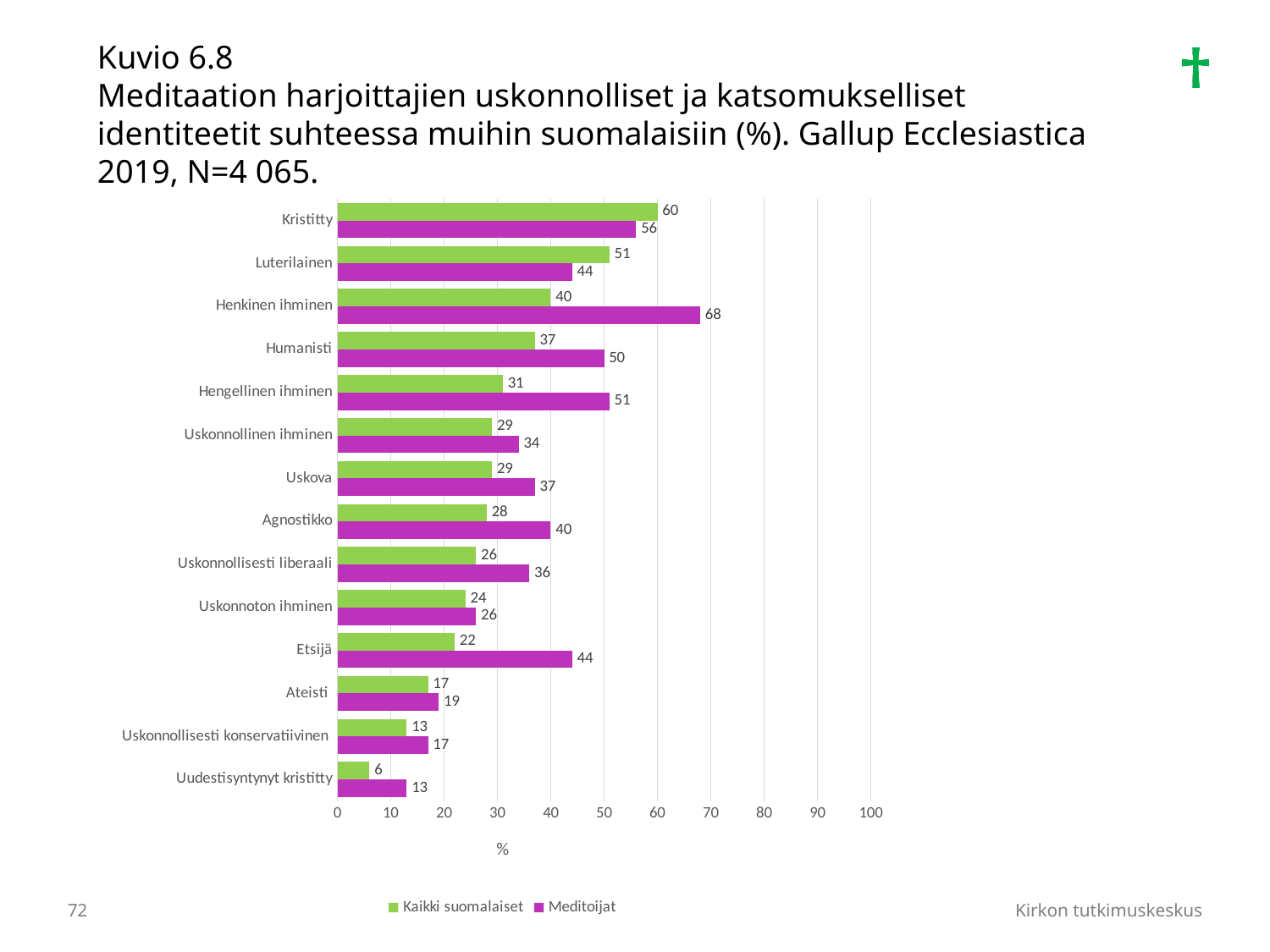
Which is larger for Luterilainen: the value for Kaikki suomalaiset or for Meditoijat? Kaikki suomalaiset Which category has the highest value for Meditoijat? Henkinen ihminen What kind of chart is shown on the slide? Bar chart Which category has the lowest value for Kaikki suomalaiset? Uudestisyntynyt kristitty How many series does the legend list? 2 How many categories are shown on the chart? 14 What is the difference between the Meditoijat and Kaikki suomalaiset values for Hengellinen ihminen? 20 Which colour represents the Meditoijat series? Purple What is the value for Meditoijat in the Henkinen ihminen category? 68 What is the value for Kaikki suomalaiset in the Kristitty category? 60 What is the difference between the Meditoijat and Kaikki suomalaiset values for Uudestisyntynyt kristitty? 7 What is the value for Meditoijat in the Etsijä category? 44